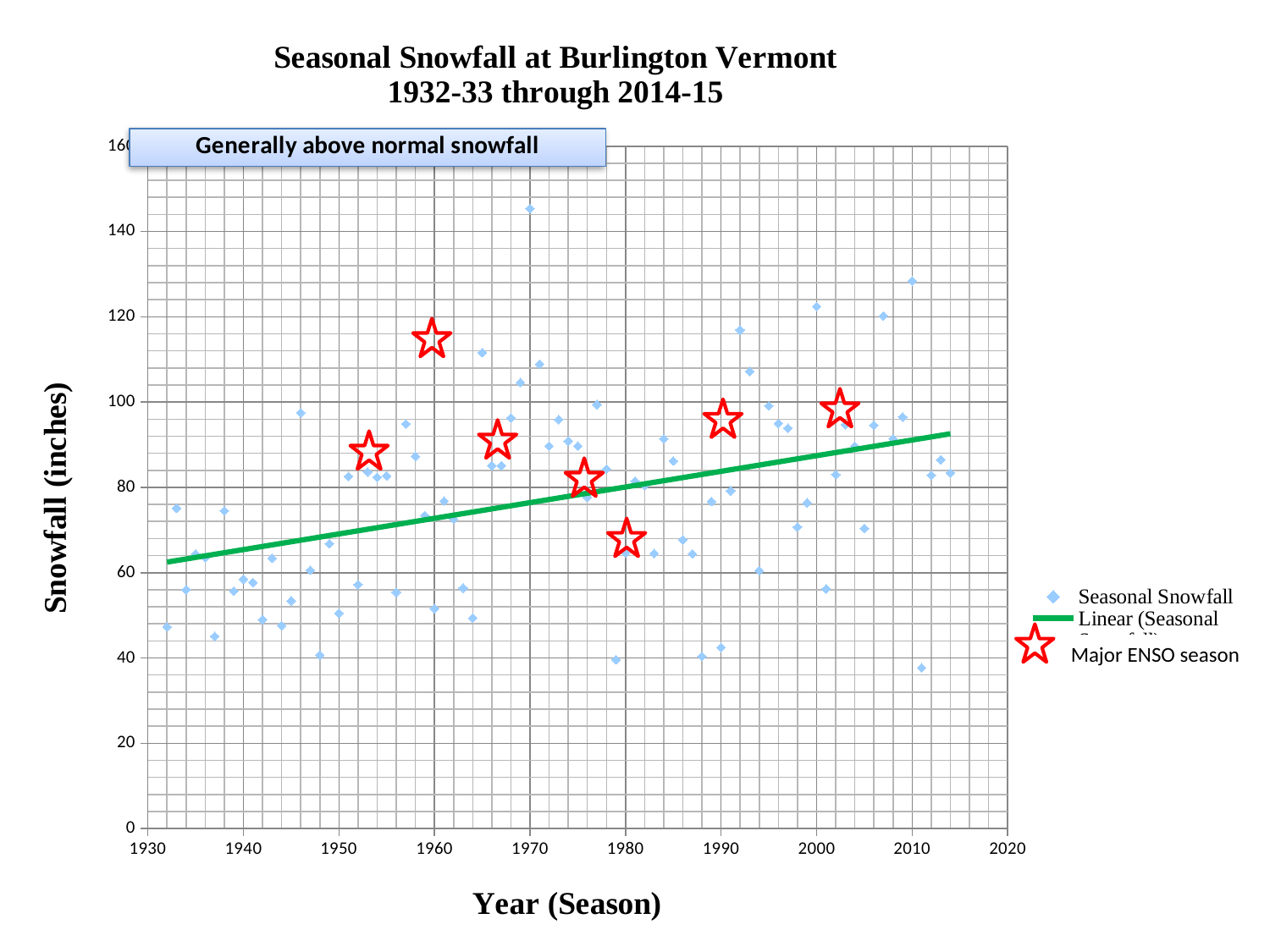
According to the green linear trend line, do seasonal snowfall values rise or fall from 1930 to 2020? rise How many entries does the legend list? 3 Is the value of the green trend line at 2014 greater or less than 80 inches? greater How many red star markers for Major ENSO seasons are plotted on the chart? 7 Is the value of the green trend line at 1930 greater or less than 80 inches? less What is the label of the vertical axis? Snowfall (inches) Is the seasonal snowfall point plotted around 2010 greater or less than 120 inches? greater What kind of chart is shown on the slide? scatter chart What is the title of the chart? Seasonal Snowfall at Burlington Vermont 1932-33 through 2014-15 What is the highest tick value shown on the vertical axis? 160